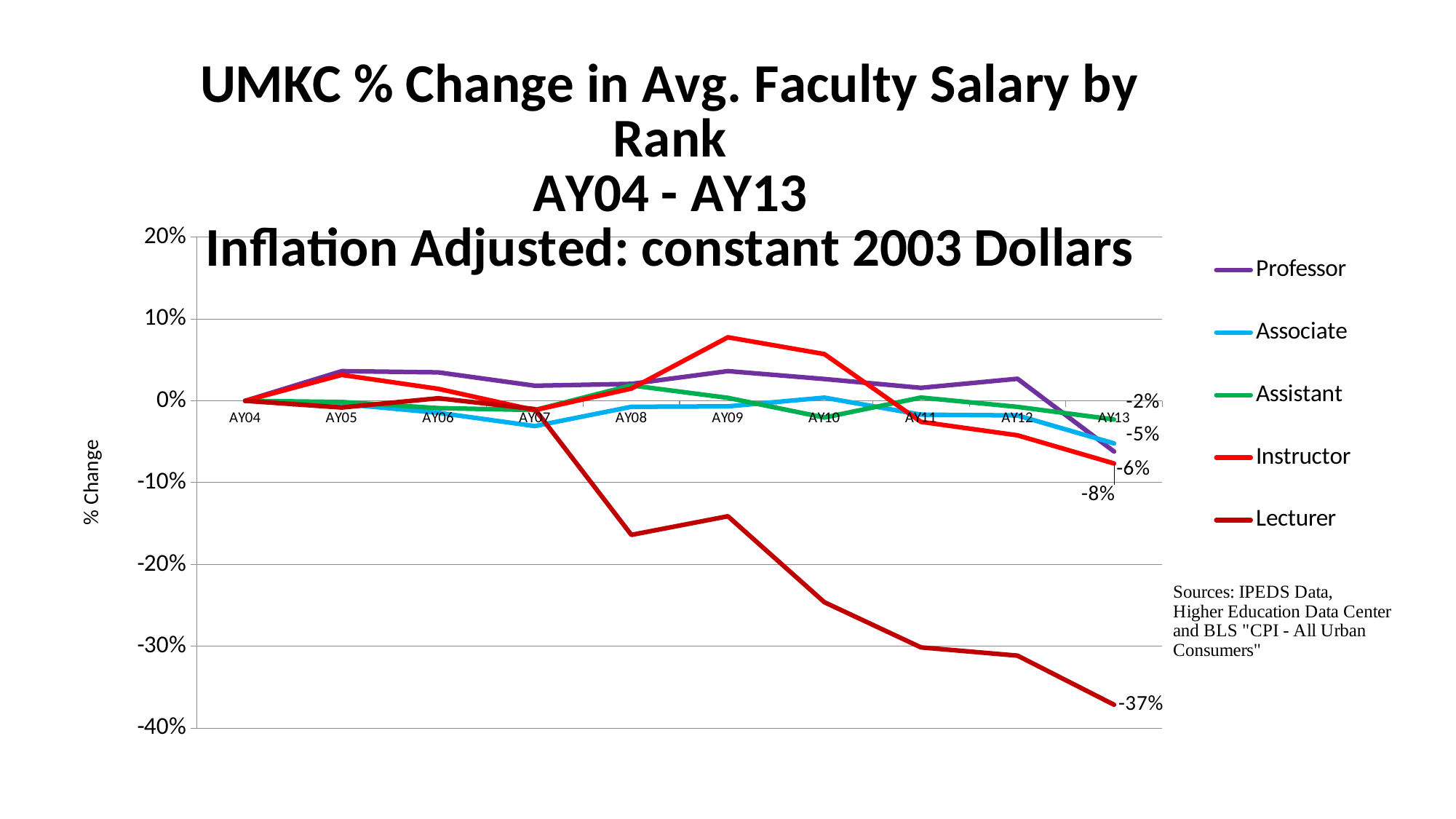
Which rank has the highest value at AY13? Assistant Is the value for Lecturer at AY10 greater or less than -20%? less Is the value for Instructor at AY09 greater or less than 5%? greater Does the Lecturer line rise or fall from AY07 to AY13? fall How many academic years are plotted along the x axis? 10 What is the difference between the Instructor and Lecturer values at AY13? 29 percentage points What kind of chart is shown on the slide? line chart What is the value for Assistant at AY13? -2% How many series does the legend list? 5 What is the value for Lecturer at AY13? -37% Which rank has the lowest value at AY13? Lecturer What is the value for Instructor at AY13? -8%